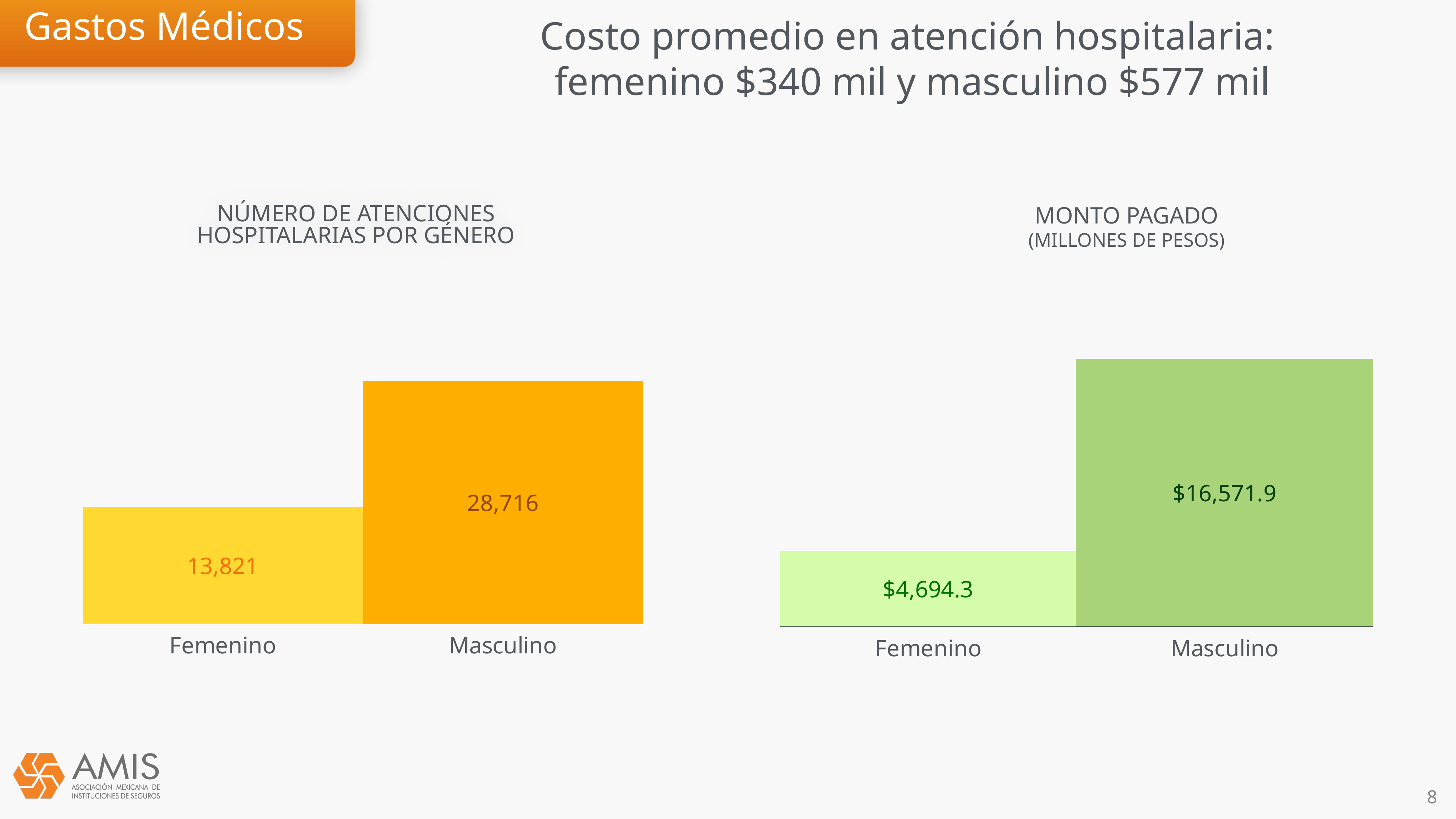
In the 'NÚMERO DE ATENCIONES HOSPITALARIAS POR GÉNERO' chart, which category has the highest value? Masculino In the 'NÚMERO DE ATENCIONES HOSPITALARIAS POR GÉNERO' chart, what is the difference between the Masculino and Femenino values? 14,895 In the 'MONTO PAGADO (MILLONES DE PESOS)' chart, what is the difference between the Masculino and Femenino values? $11,877.6 In the 'MONTO PAGADO (MILLONES DE PESOS)' chart, what is the value for Femenino? $4,694.3 How many categories are shown in the 'NÚMERO DE ATENCIONES HOSPITALARIAS POR GÉNERO' chart? 2 In the 'MONTO PAGADO (MILLONES DE PESOS)' chart, which is larger, the value for Femenino or Masculino? Masculino In the 'NÚMERO DE ATENCIONES HOSPITALARIAS POR GÉNERO' chart, what is the value for Femenino? 13,821 In the 'MONTO PAGADO (MILLONES DE PESOS)' chart, what is the value for Masculino? $16,571.9 In the 'NÚMERO DE ATENCIONES HOSPITALARIAS POR GÉNERO' chart, what is the value for Masculino? 28,716 In the 'MONTO PAGADO (MILLONES DE PESOS)' chart, which category has the lowest value? Femenino What kind of chart is the 'MONTO PAGADO (MILLONES DE PESOS)' chart? Bar chart What is the title of the chart on the left side of the slide? NÚMERO DE ATENCIONES HOSPITALARIAS POR GÉNERO